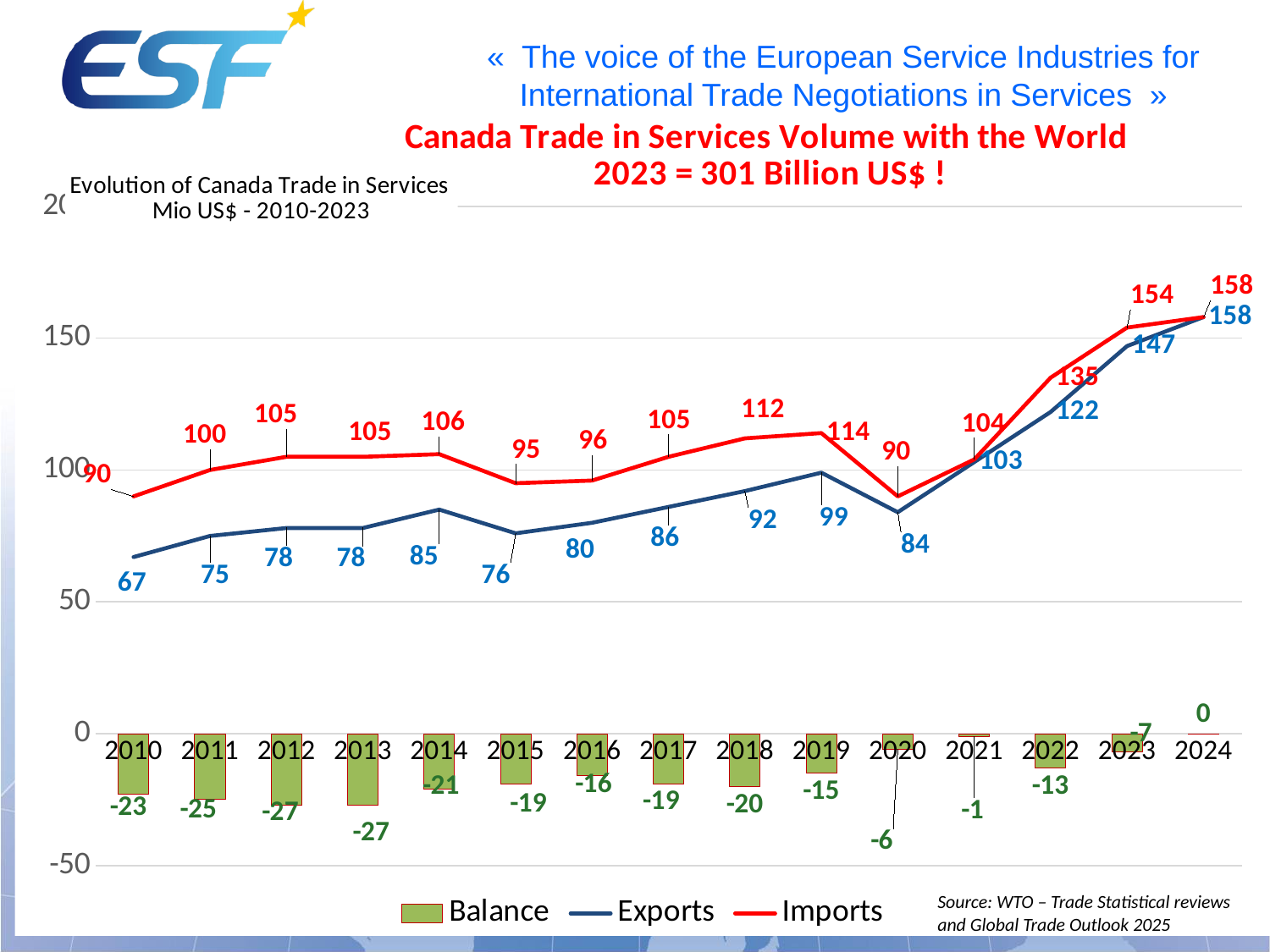
What is the value of Exports in 2022? 122 Do Exports rise or fall from 2020 to 2024? rise How many years are shown on the x axis? 15 How many series does the legend list? 3 Is the Exports value for 2023 greater or less than 100? greater What is the Balance value in 2013? -27 Which is larger in 2020, Imports or Exports? Imports In which year is the Imports series at its highest? 2024 In which year is the Exports series at its lowest? 2010 What is the value of Imports in 2019? 114 Which series is shown as green bars in the legend? Balance What is the difference between Imports and Exports in 2010? 23